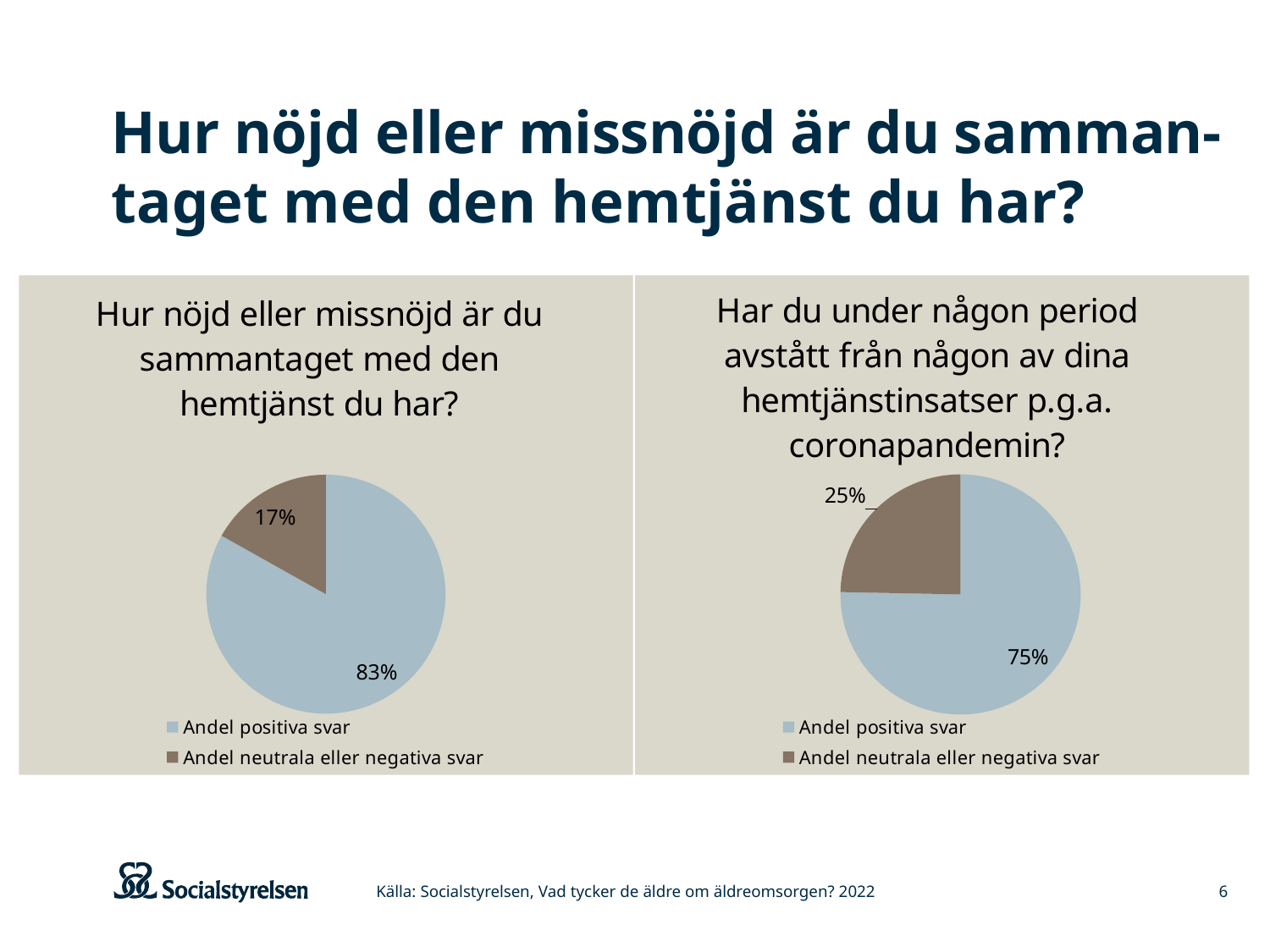
What type of chart is used on the left side of the slide? Pie chart In the right chart ("Har du under någon period avstått från någon av dina hemtjänstinsatser p.g.a. coronapandemin?"), what share is labelled for Andel positiva svar? 75% In the right chart ("Har du under någon period avstått från någon av dina hemtjänstinsatser p.g.a. coronapandemin?"), what share is labelled for Andel neutrala eller negativa svar? 25% In the right chart, what is the difference in percentage points between Andel positiva svar and Andel neutrala eller negativa svar? 50 percentage points In the left chart, which slice is the largest? Andel positiva svar In the left chart, what is the difference in percentage points between Andel positiva svar and Andel neutrala eller negativa svar? 66 percentage points How many slices does the right chart have? 2 Which chart has the larger share for Andel positiva svar, the left chart or the right chart? The left chart In the right chart, which slice is the smallest? Andel neutrala eller negativa svar In the left chart ("Hur nöjd eller missnöjd är du sammantaget med den hemtjänst du har?"), what share is labelled for Andel positiva svar? 83% How many entries does the legend of the left chart list? 2 In the left chart ("Hur nöjd eller missnöjd är du sammantaget med den hemtjänst du har?"), what share is labelled for Andel neutrala eller negativa svar? 17%